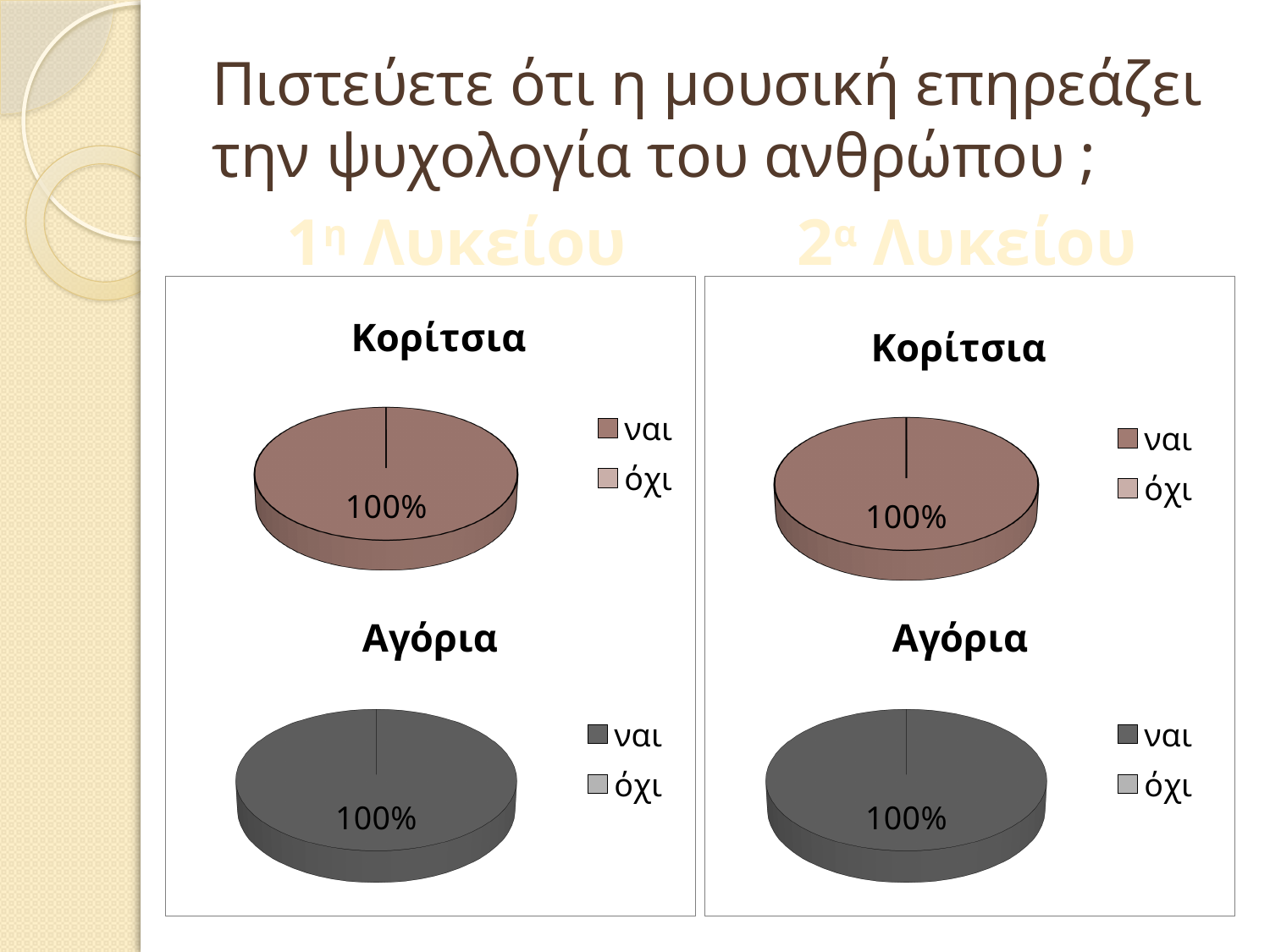
How many pie charts are shown on the slide in total? 4 What kind of chart is the "Κορίτσια" chart in the left panel? pie chart In the left panel, what share of the "Κορίτσια" pie is labelled on the slide? 100% What are the two legend entries of the "Κορίτσια" chart in the left panel? ναι, όχι What is the title of the lower chart in the right panel? Αγόρια In the left panel "Αγόρια" chart, is the share for "ναι" greater or less than 50%? greater In the right panel, what share of the "Αγόρια" pie is labelled on the slide? 100% How many entries does the legend of the "Αγόρια" chart in the right panel list? 2 In the left panel "Κορίτσια" chart, which legend category makes up the whole pie? ναι In the right panel "Αγόρια" chart, which legend category makes up the whole pie? ναι In the right panel, what share of the "Κορίτσια" pie is labelled on the slide? 100%